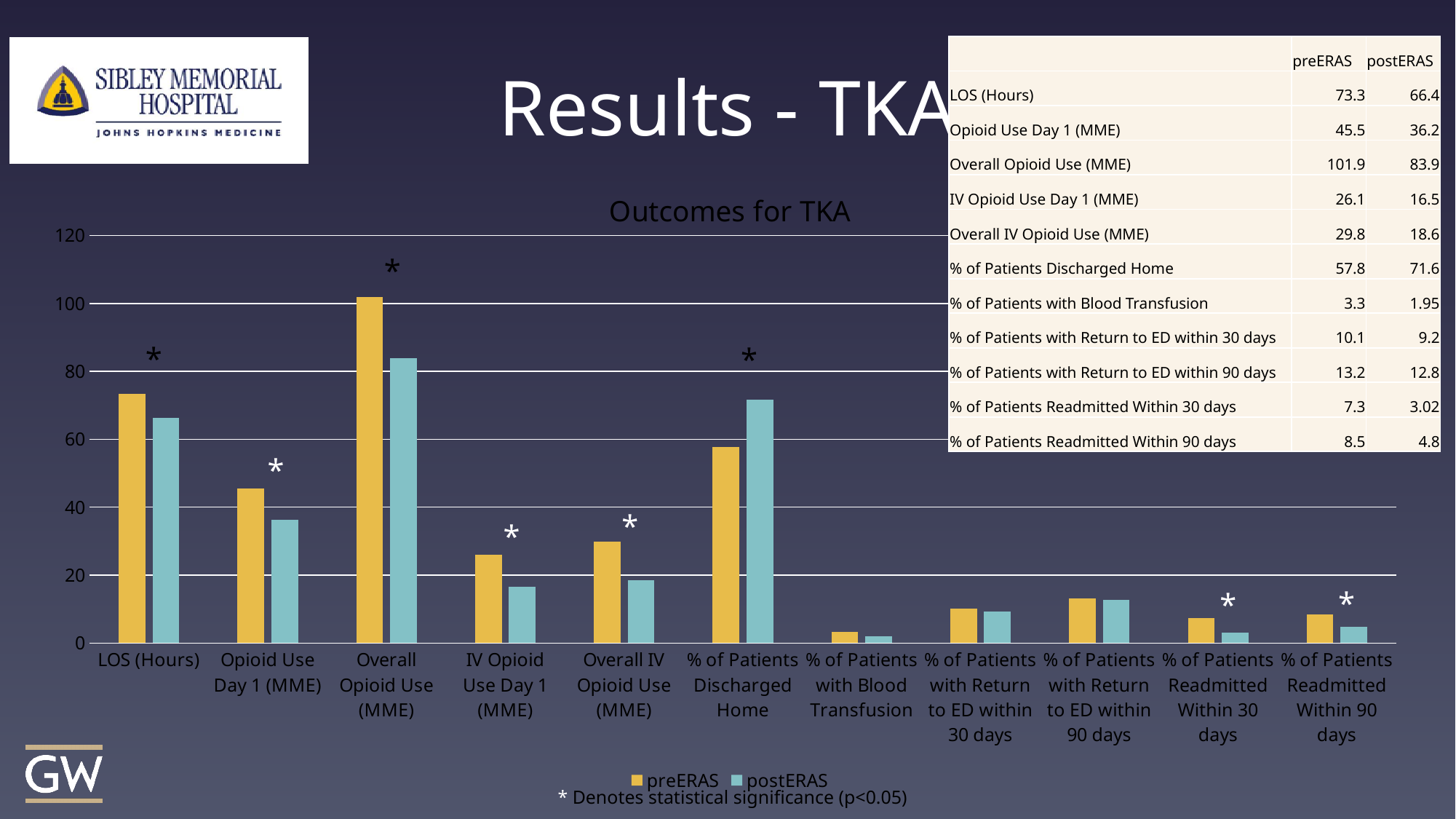
Which category has the highest preERAS value? Overall Opioid Use (MME) What type of chart is shown on the slide? bar chart What is the postERAS value for LOS (Hours)? 66.4 What is the title of the chart? Outcomes for TKA Is the postERAS value for Overall Opioid Use (MME) greater or less than 80? greater What is the preERAS value for Overall Opioid Use (MME)? 101.9 What is the difference between the preERAS and postERAS values for IV Opioid Use Day 1 (MME)? 9.6 Which category has the lowest postERAS value? % of Patients with Blood Transfusion Is the preERAS value for Opioid Use Day 1 (MME) greater or less than 40? greater How many series does the chart legend list? 2 How many categories are shown along the x axis of the chart? 11 Which is larger for % of Patients Discharged Home, the preERAS or the postERAS value? postERAS